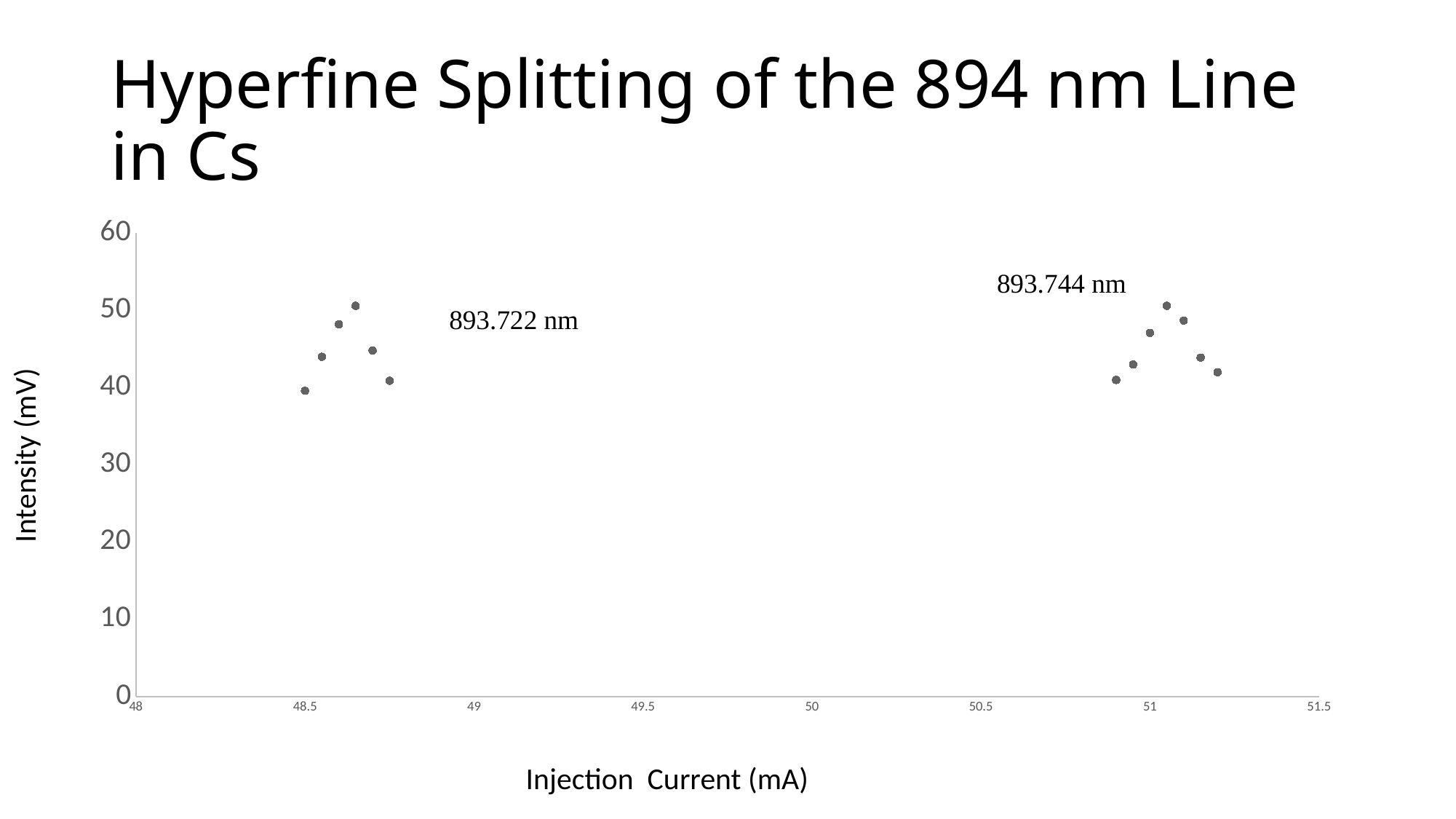
What is the label of the y axis? Intensity (mV) How many data points are in the cluster labelled 893.722 nm? 6 Is the highest intensity in the 893.744 nm cluster greater or less than 40? greater Is the intensity at an injection current of 48.5 mA greater or less than 30? greater How many data points are in the cluster labelled 893.744 nm? 7 In the 893.722 nm cluster, do the intensity values rise or fall as injection current increases from 48.5 mA to 48.65 mA? rise In the 893.744 nm cluster, do the intensity values rise or fall as injection current increases from 51.05 mA to 51.2 mA? fall Which cluster appears at higher injection currents, 893.722 nm or 893.744 nm? 893.744 nm Is the highest intensity in the 893.722 nm cluster greater or less than 60? less What kind of chart is shown on the slide? scatter chart What is the title of the chart on the slide? Hyperfine Splitting of the 894 nm Line in Cs